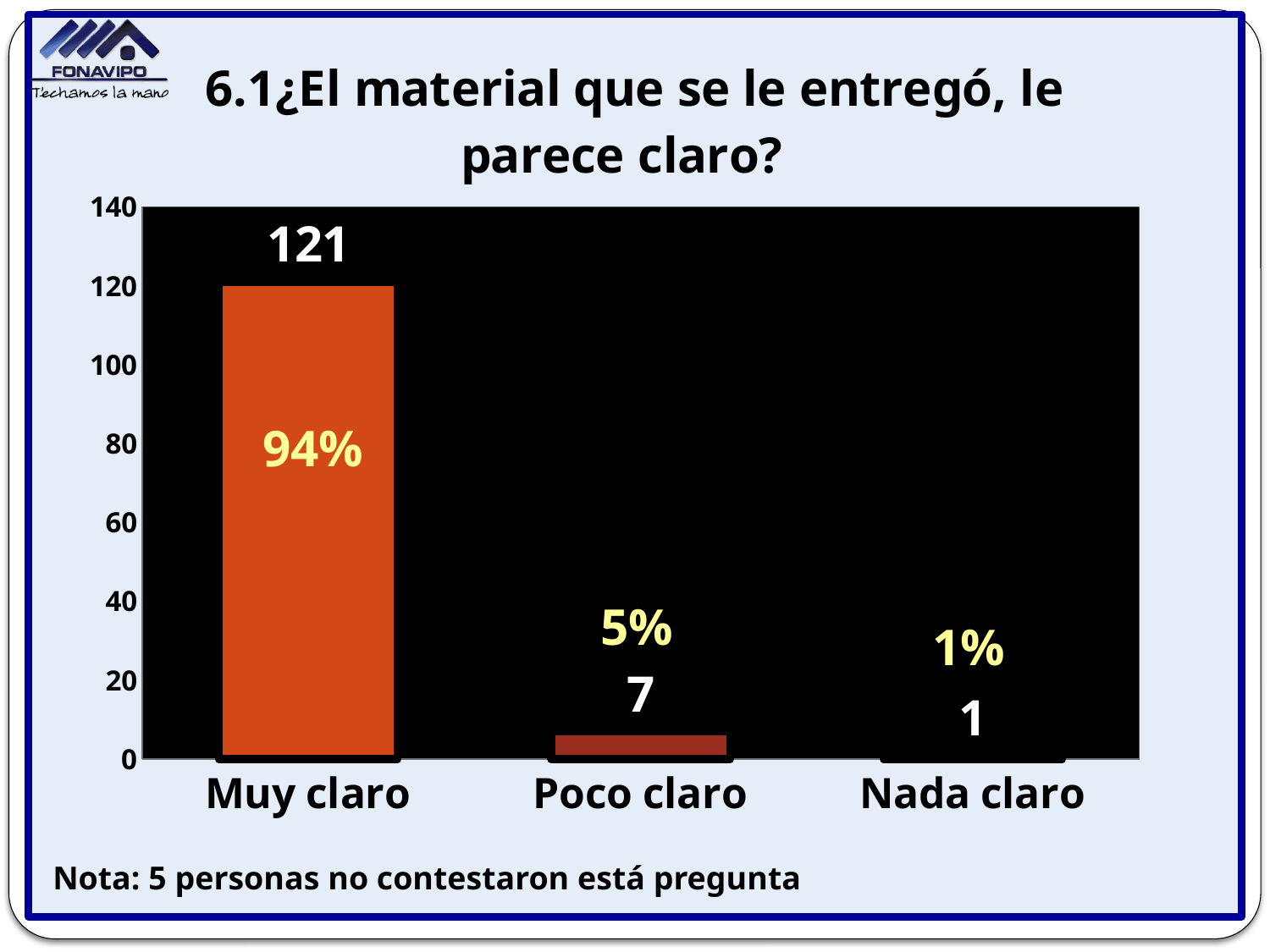
Is the value for Muy claro greater or less than 100? greater What percentage is shown for Poco claro? 5% Which is larger, the value for Poco claro or the value for Nada claro? Poco claro What is the value for Muy claro? 121 Which category has the lowest value? Nada claro What percentage is shown for Muy claro? 94% What is the value for Nada claro? 1 How many categories are shown on the x axis? 3 What is the value for Poco claro? 7 Which category has the highest value? Muy claro What is the difference between the values for Muy claro and Poco claro? 114 What kind of chart is shown on the slide? bar chart